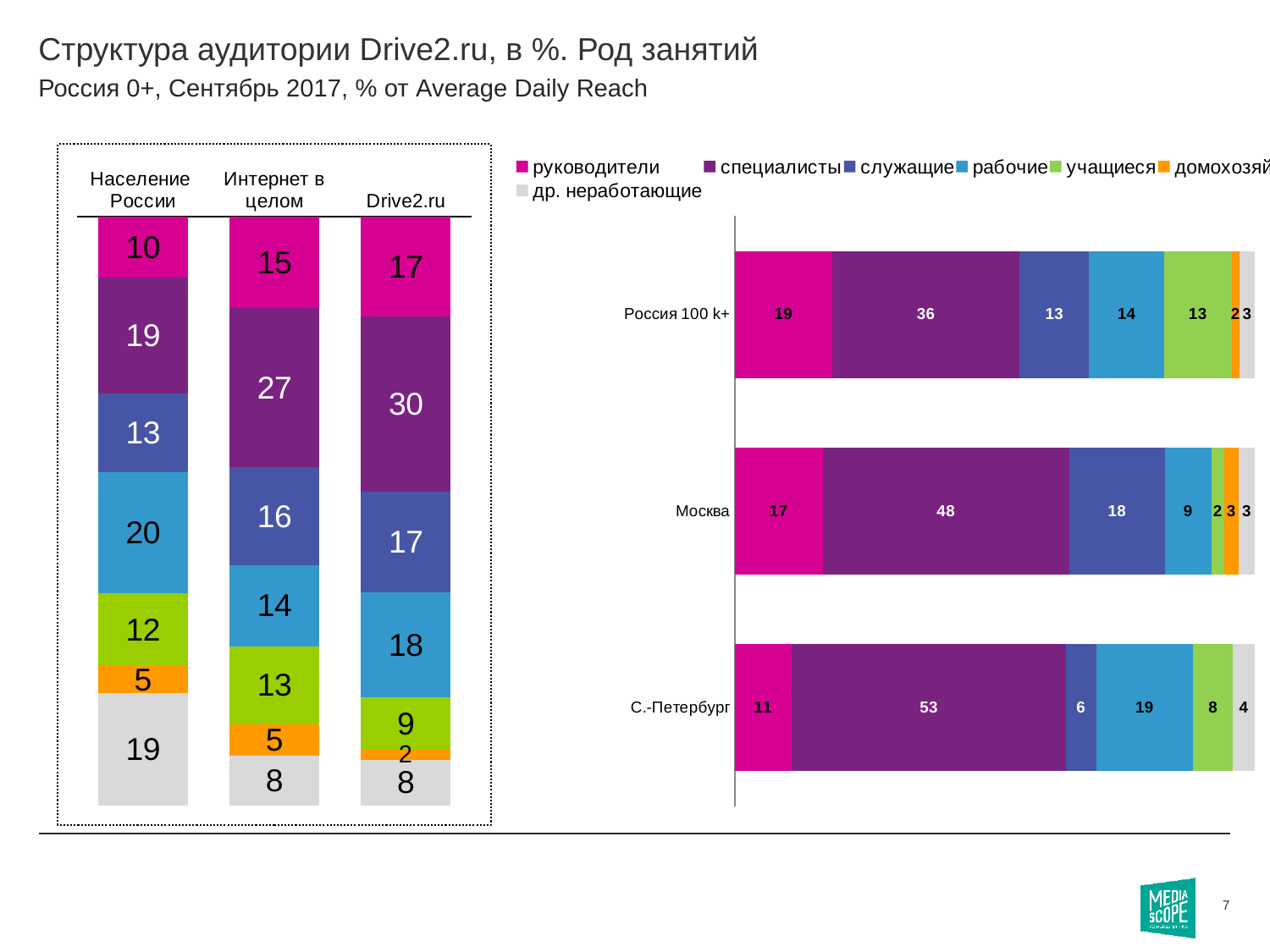
In the right chart, what is the value of the служащие segment for Москва? 18 In the left chart, what is the value of the рабочие (light blue) segment for Интернет в целом? 14 How many series does the legend of the right chart list? 7 What type of chart is the right chart? Stacked bar chart In the left chart, what is the value of the специалисты (purple) segment for Drive2.ru? 30 In the left chart, what is the difference between the др. неработающие (grey) segment for Население России and for Drive2.ru? 11 In the right chart, which region has the highest руководители value? Россия 100 k+ In the right chart, is the специалисты value larger for Москва or for Россия 100 k+? Москва In the left chart, what is the value of the руководители (pink) segment for Население России? 10 In the left chart, how many columns (audience groups) are shown? 3 In the right chart, what is the value of the специалисты segment for С.-Петербург? 53 In the left chart, which of the three columns has the largest специалисты (purple) segment? Drive2.ru